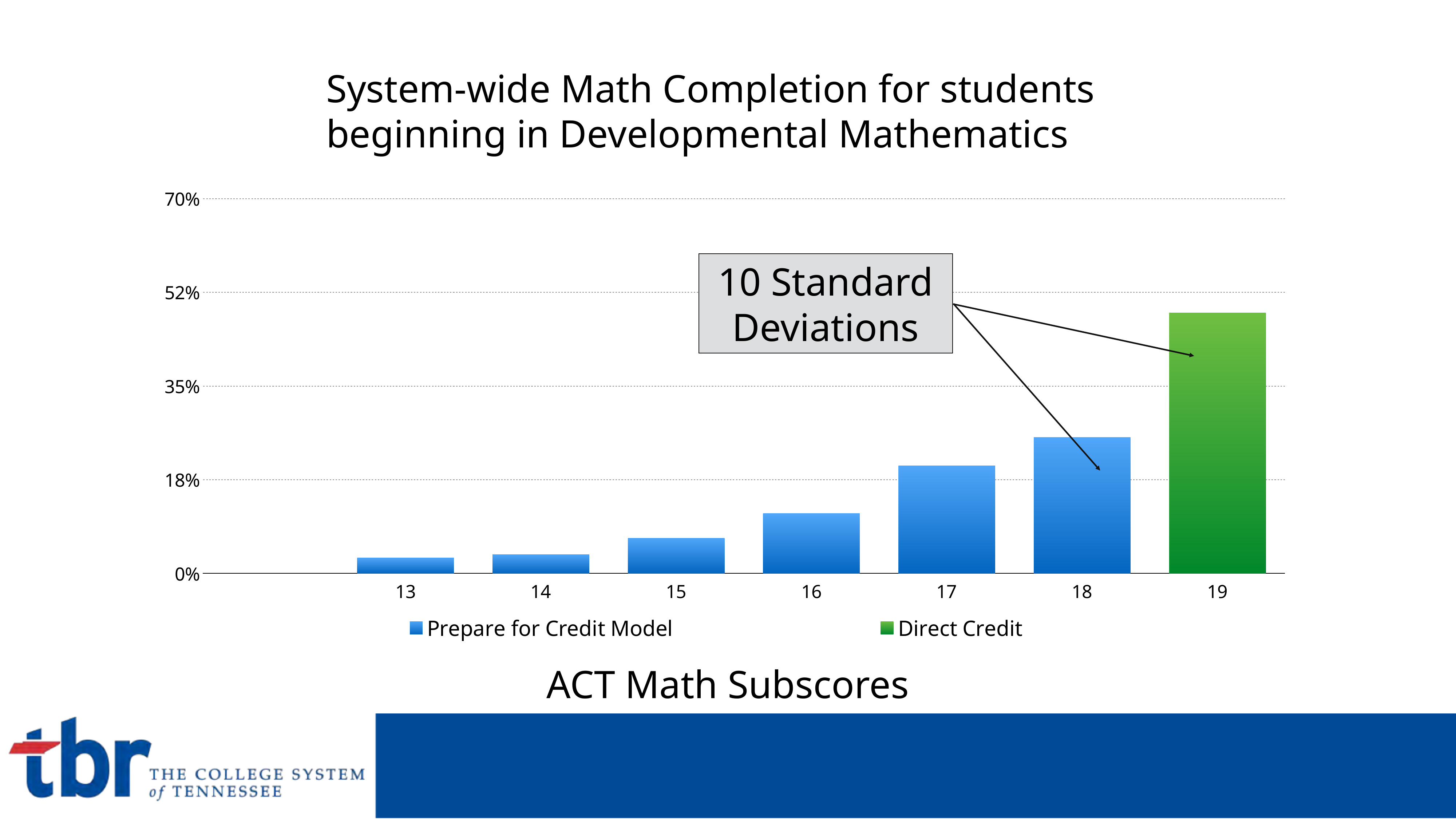
Is the value for subscore 19 greater or less than 52%? less How many series does the legend list? 2 Is the value for subscore 18 greater or less than 18%? greater Which ACT Math Subscore has the highest completion rate? 19 Which has a larger value, subscore 17 or subscore 16? 17 Do the values rise or fall as the ACT Math Subscore increases from 13 to 19? rise What does the annotation box on the chart say? 10 Standard Deviations Is the value for subscore 16 greater or less than 18%? less What kind of chart is shown on the slide? bar chart Which series does the green bar for subscore 19 belong to? Direct Credit How many ACT Math Subscore categories are plotted on the x axis? 7